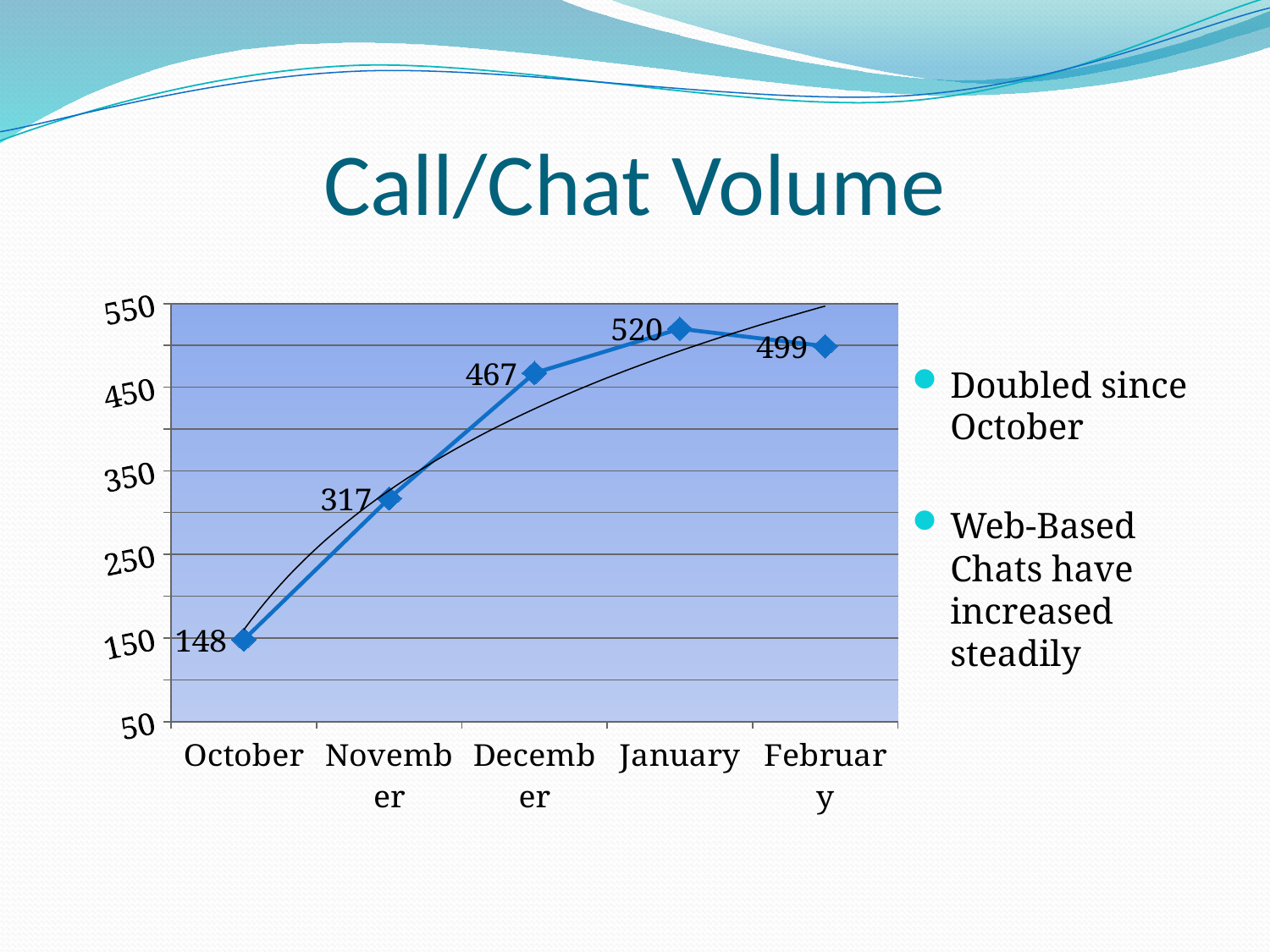
What is the difference between the January and February values? 21 Which month has the lowest value? October Which is larger, the value for December or the value for February? February Which month has the highest value? January What is the value for December? 467 What kind of chart is shown on the slide? line chart How many months are plotted on the chart? 5 What is the value for February? 499 What is the difference between the November and October values? 169 What is the value for October? 148 What is the value for November? 317 What is the value for January? 520